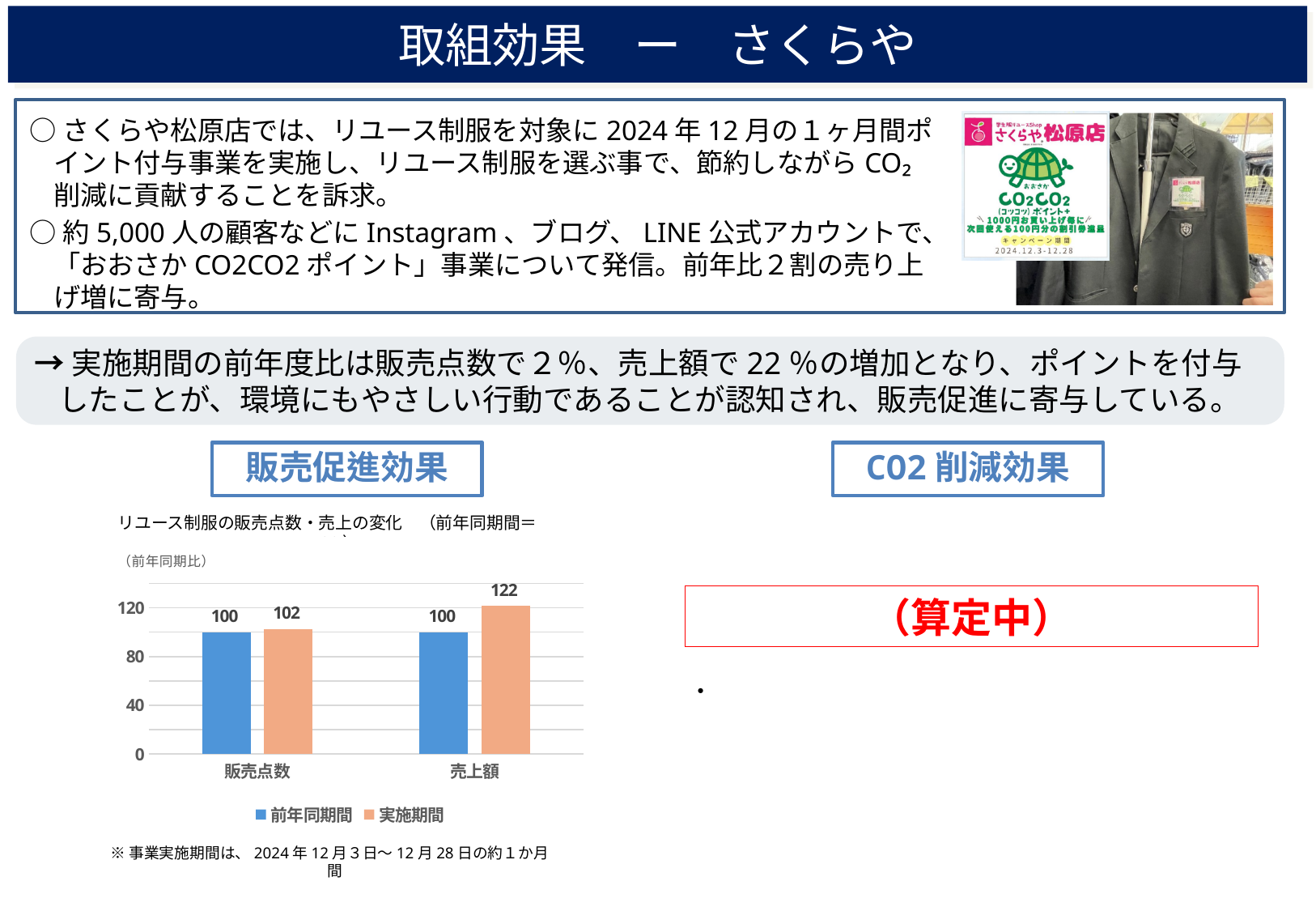
Which category has the highest 実施期間 value? 売上額 What is the value of 実施期間 for 販売点数? 102 What is the value of 前年同期間 for 売上額? 100 What is the value of 前年同期間 for 販売点数? 100 How many categories are shown on the x axis of the chart? 2 What is the difference between the 実施期間 and 前年同期間 values for 売上額? 22 Is the 実施期間 value for 売上額 greater or less than 120? greater How many series does the chart's legend list? 2 Which is larger: the 実施期間 value for 売上額 or the 実施期間 value for 販売点数? 売上額 What kind of chart is shown under 販売促進効果? bar chart What is the difference between the 実施期間 and 前年同期間 values for 販売点数? 2 What is the value of 実施期間 for 売上額? 122